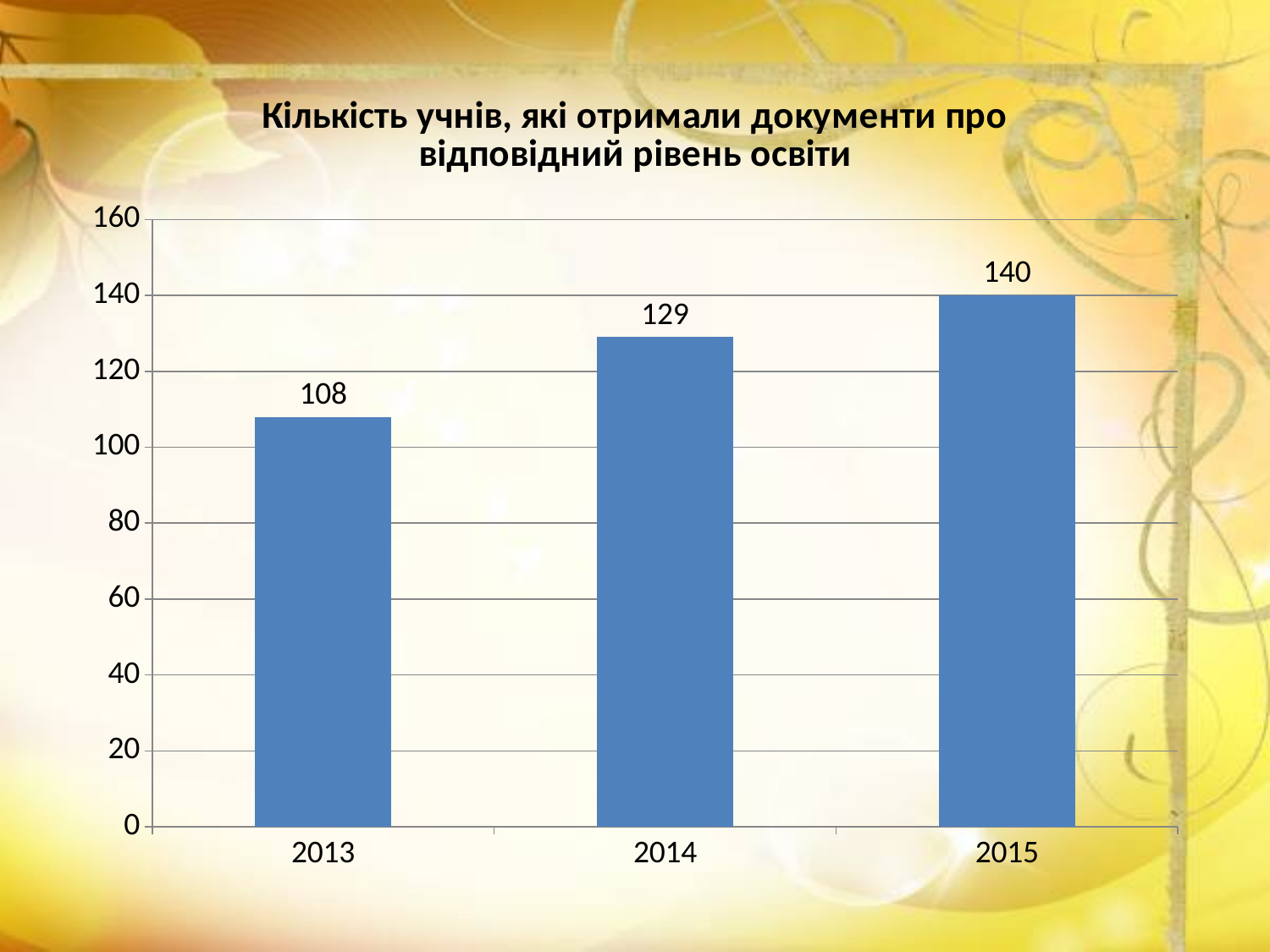
What is the value for 2013? 108 Which year has the lowest value? 2013 What is the difference between the values for 2014 and 2013? 21 Which year has the highest value? 2015 What is the value for 2015? 140 Is the value for 2014 greater or less than 120? greater Which is larger, the value for 2014 or the value for 2015? 2015 What kind of chart is shown on the slide? bar chart What is the difference between the values for 2015 and 2013? 32 What is the value for 2014? 129 Do the values rise or fall from 2013 to 2015? rise How many years are shown on the x axis? 3